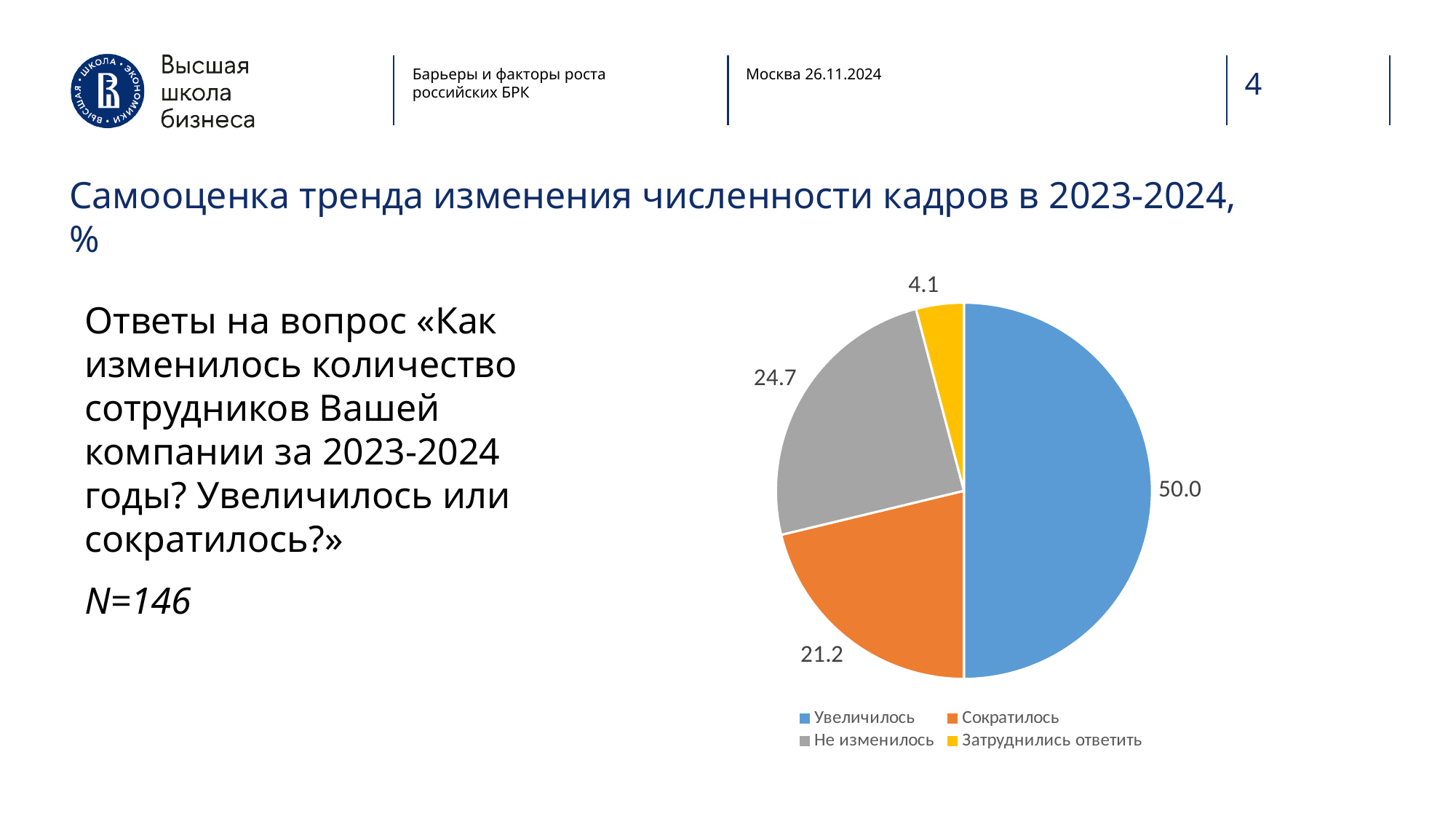
What is the value for «Затруднились ответить»? 4.1 Which category has the smallest share of the pie? Затруднились ответить What colour is the slice for «Затруднились ответить»? yellow What is the value for «Сократилось»? 21.2 What is the value for «Не изменилось»? 24.7 What type of chart is shown on the slide? pie chart Which is larger: the value for «Не изменилось» or the value for «Сократилось»? Не изменилось How many categories does the legend list? 4 Which category has the largest share of the pie? Увеличилось What is the difference between the values for «Не изменилось» and «Сократилось»? 3.5 What is the value for «Увеличилось»? 50.0 What is the sample size (N) stated on the slide? N=146